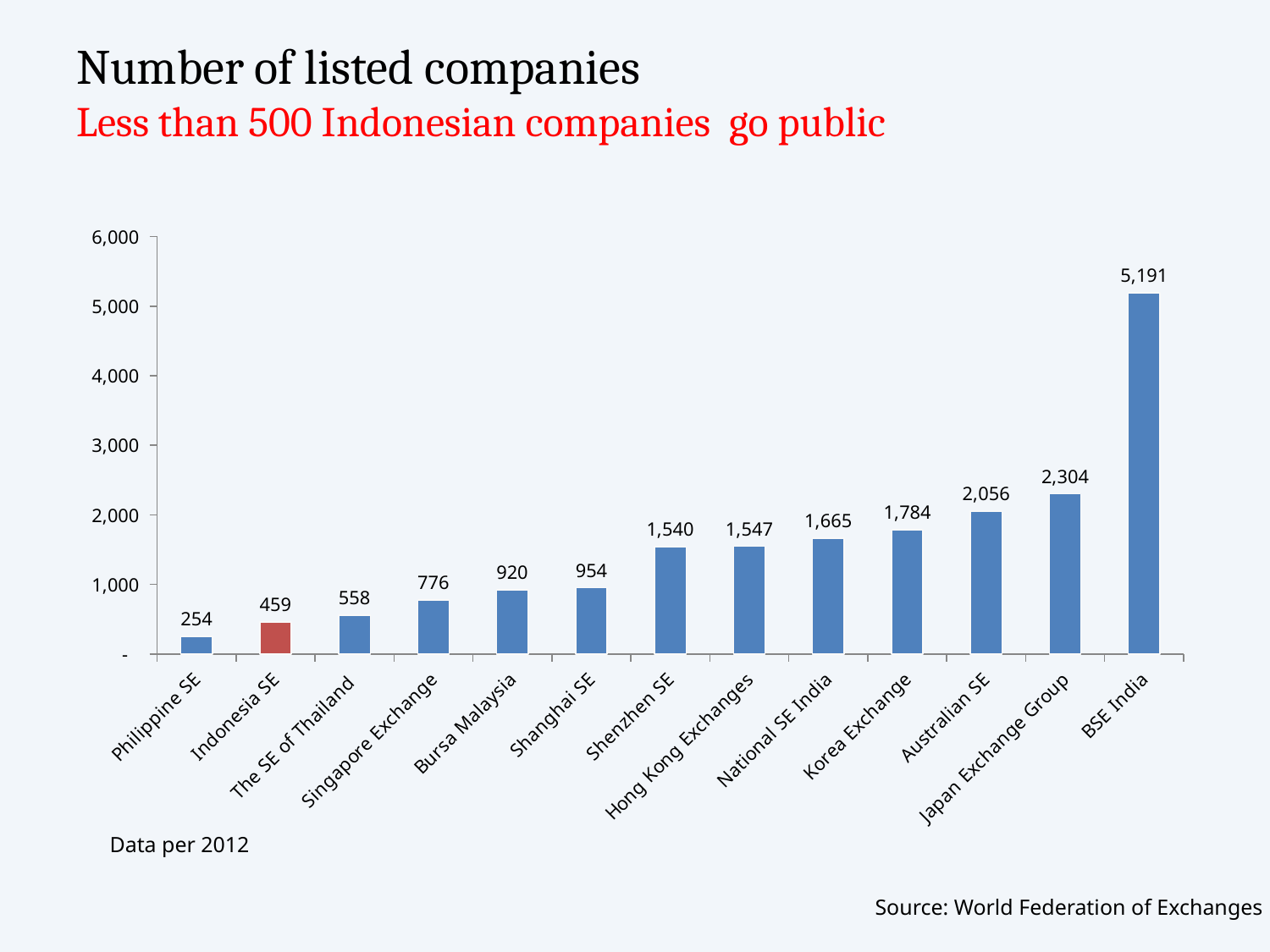
Which has more listed companies, Korea Exchange or Australian SE? Australian SE How many exchanges are shown in the chart? 13 What is the number of listed companies for Japan Exchange Group? 2,304 What is the number of listed companies for Indonesia SE? 459 Which exchange has the lowest number of listed companies? Philippine SE Which exchange has the highest number of listed companies? BSE India Is the value for Shanghai SE greater or less than 1,000? less What is the difference in listed companies between Indonesia SE and Philippine SE? 205 What type of chart is shown on the slide? Bar chart What is the difference in listed companies between BSE India and Japan Exchange Group? 2,887 Which bar is highlighted in a different colour (red) from the others? Indonesia SE What is the number of listed companies for Hong Kong Exchanges? 1,547